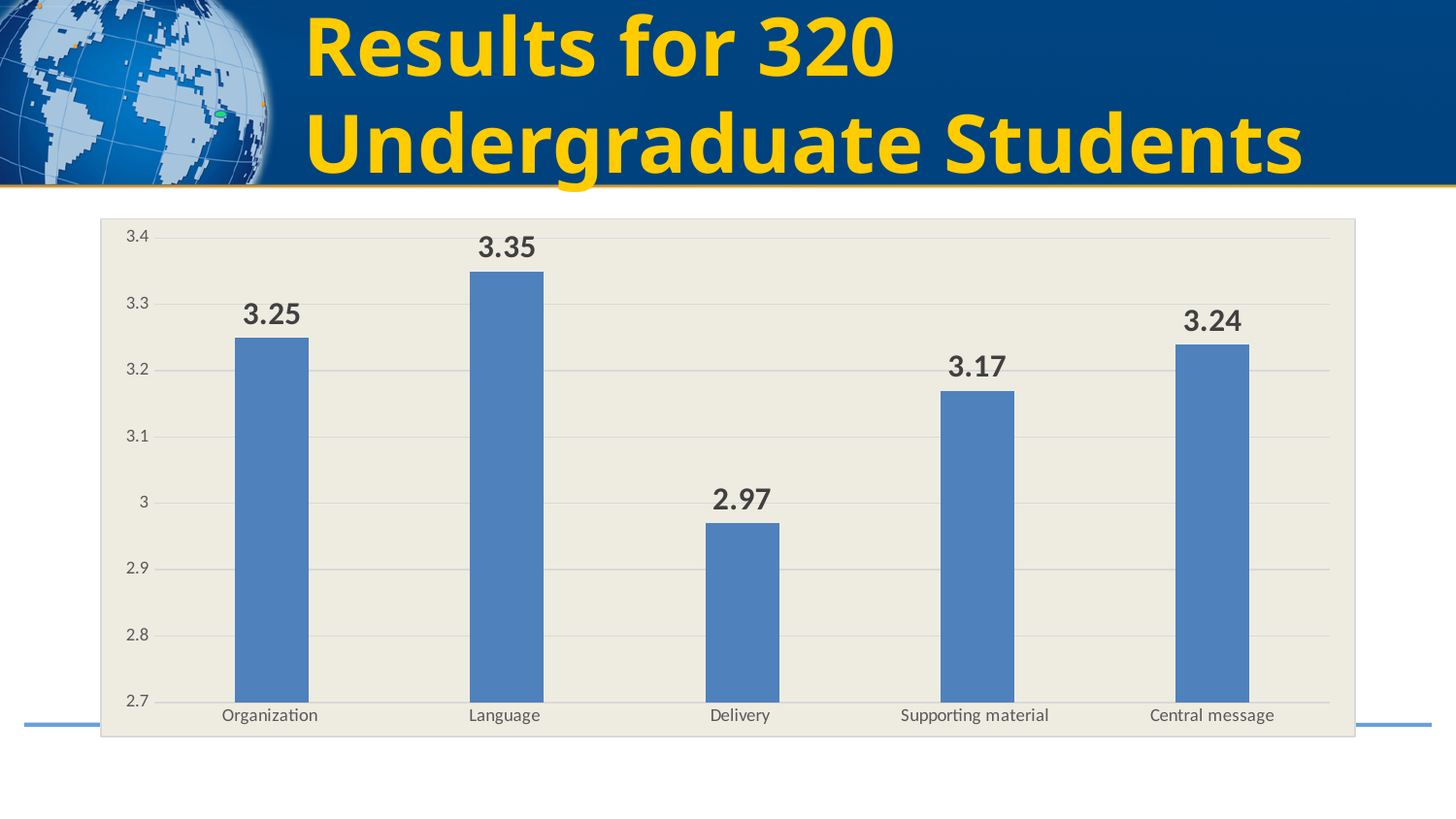
What is the difference between the values for Organization and Central message? 0.01 What is the value for Delivery? 2.97 What is the title of the slide? Results for 320 Undergraduate Students Is the value for Delivery greater or less than 3? less Which is larger, the value for Supporting material or the value for Central message? Central message What is the value for Organization? 3.25 What kind of chart is shown on the slide? bar chart How many categories are shown on the x axis? 5 Which category has the lowest value? Delivery What is the value for Supporting material? 3.17 Which category has the highest value? Language What is the difference between the values for Language and Delivery? 0.38